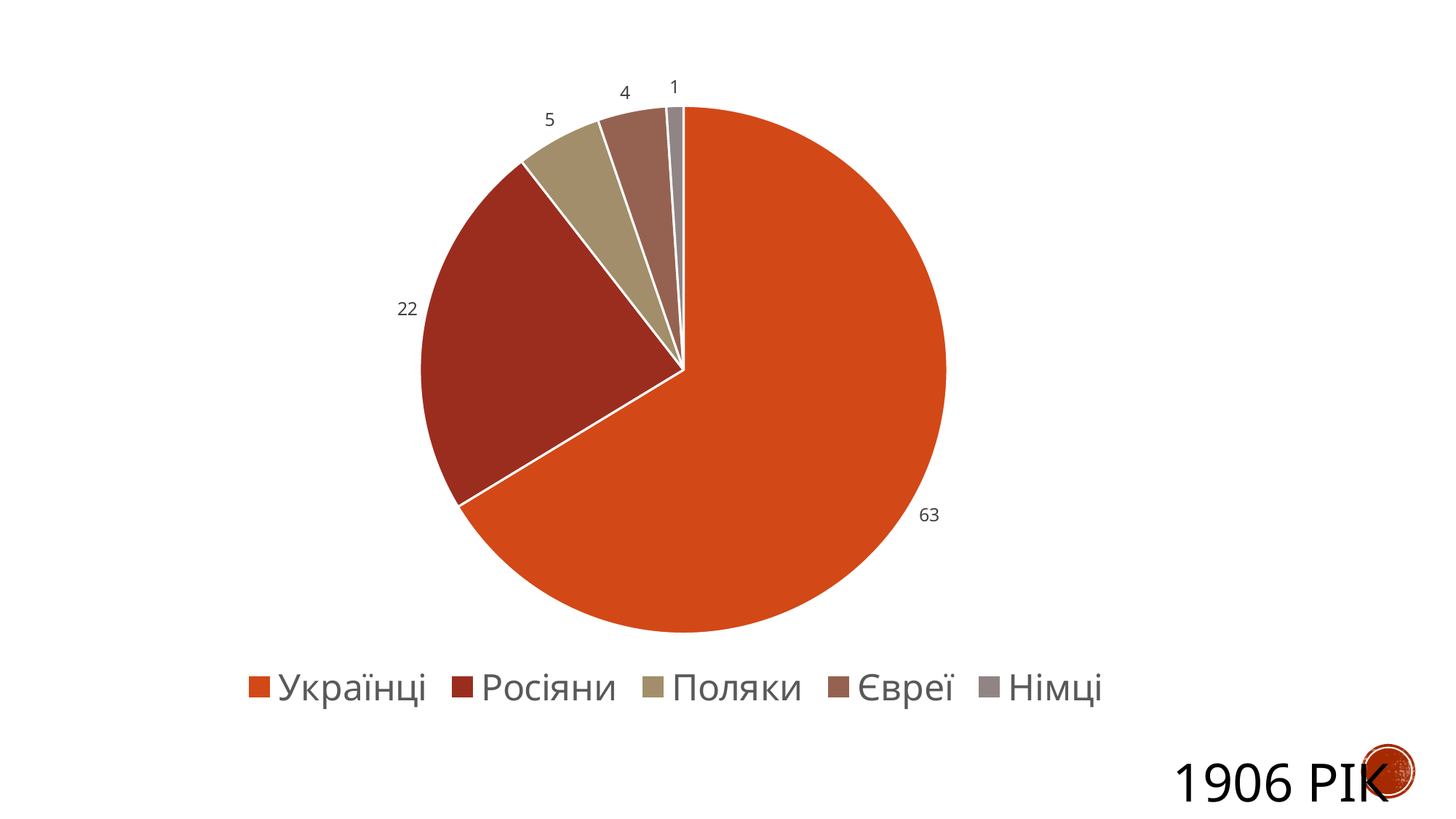
Which is larger, the value for Поляки or the value for Євреї? Поляки What type of chart is shown on the slide? pie chart What is the value for Німці? 1 What year is indicated in the text at the bottom right of the slide? 1906 What is the difference between the values for Українці and Росіяни? 41 What is the value for Українці? 63 What is the value for Євреї? 4 What is the value for Поляки? 5 What is the value for Росіяни? 22 Which category has the smallest slice? Німці Which category has the largest slice? Українці How many categories does the pie chart have? 5